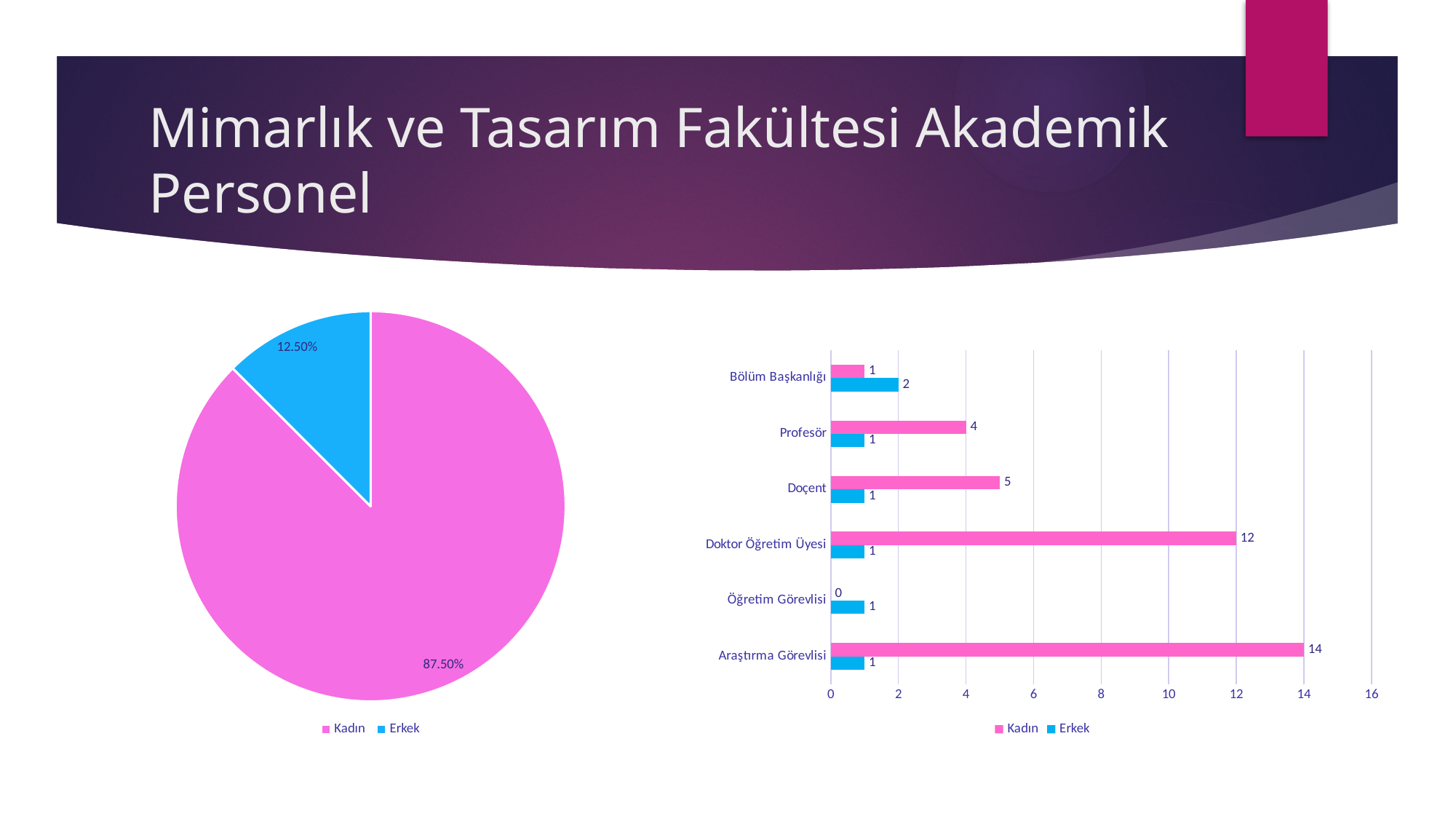
In the pie chart on the left, what share does Erkek have? 12.50% In the pie chart on the left, what share does Kadın have? 87.50% In the bar chart on the right, which category has the highest Kadın value? Araştırma Görevlisi In the bar chart on the right, which is larger for Profesör, the Kadın value or the Erkek value? Kadın In the bar chart on the right, what is the Erkek value for Bölüm Başkanlığı? 2 In the bar chart on the right, what is the Kadın value for Araştırma Görevlisi? 14 In the pie chart on the left, which slice is larger, Kadın or Erkek? Kadın In the bar chart on the right, how many series does the legend list? 2 In the bar chart on the right, what is the Kadın value for Öğretim Görevlisi? 0 In the bar chart on the right, how many categories are shown? 6 In the bar chart on the right, what is the difference between the Kadın and Erkek values for Doktor Öğretim Üyesi? 11 What kind of chart is the chart on the right? bar chart